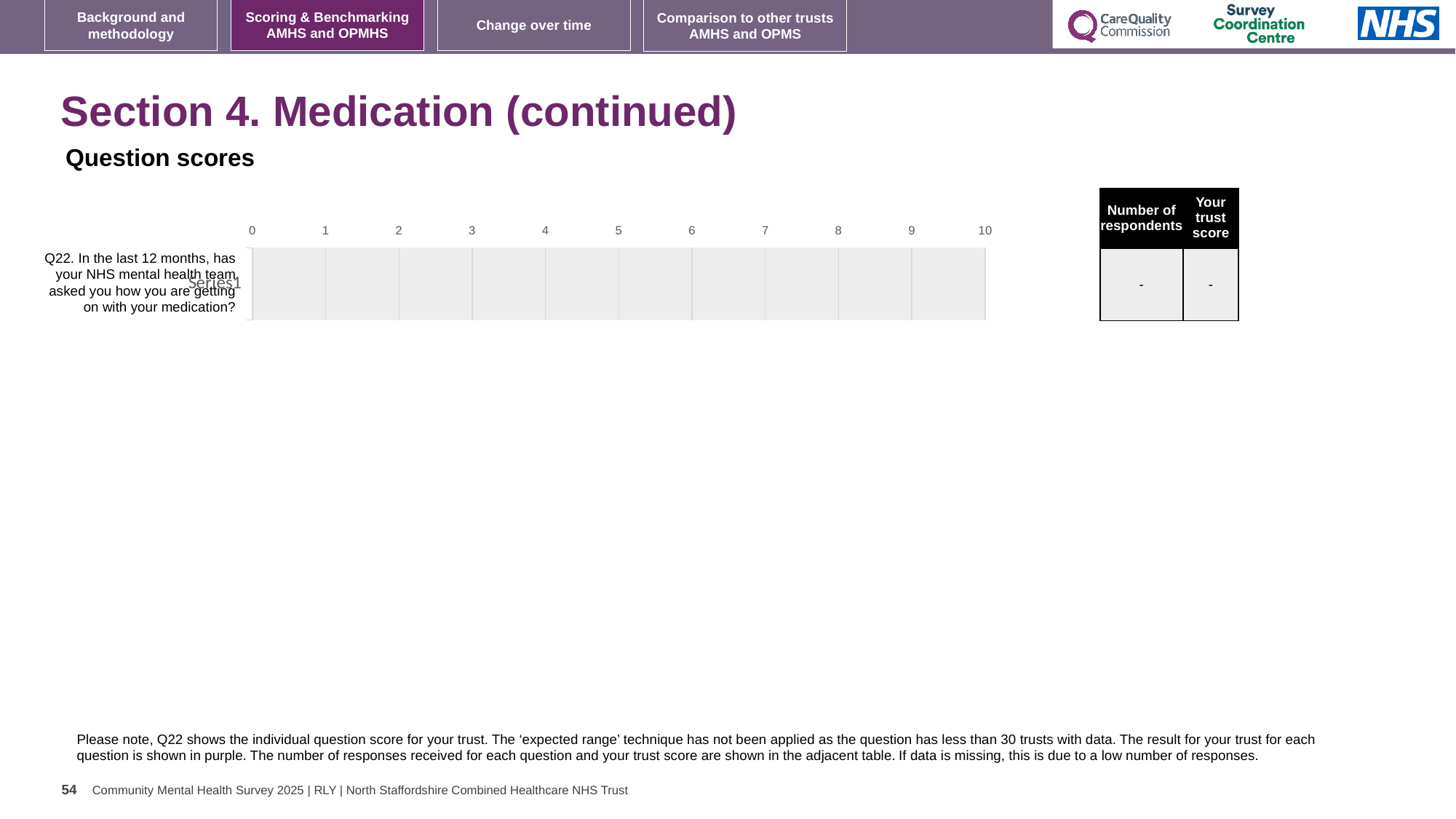
What is the highest value shown on the chart's horizontal axis? 10 What is the lowest value shown on the chart's horizontal axis? 0 What is the 'Your trust score' value shown in the table for Q22? - What kind of chart is shown under 'Question scores'? Bar chart What is the 'Number of respondents' value shown in the table for Q22? - How many questions (categories) are listed on the chart's vertical axis? 1 Which question is shown on the chart? Q22. In the last 12 months, has your NHS mental health team asked you how you are getting on with your medication?